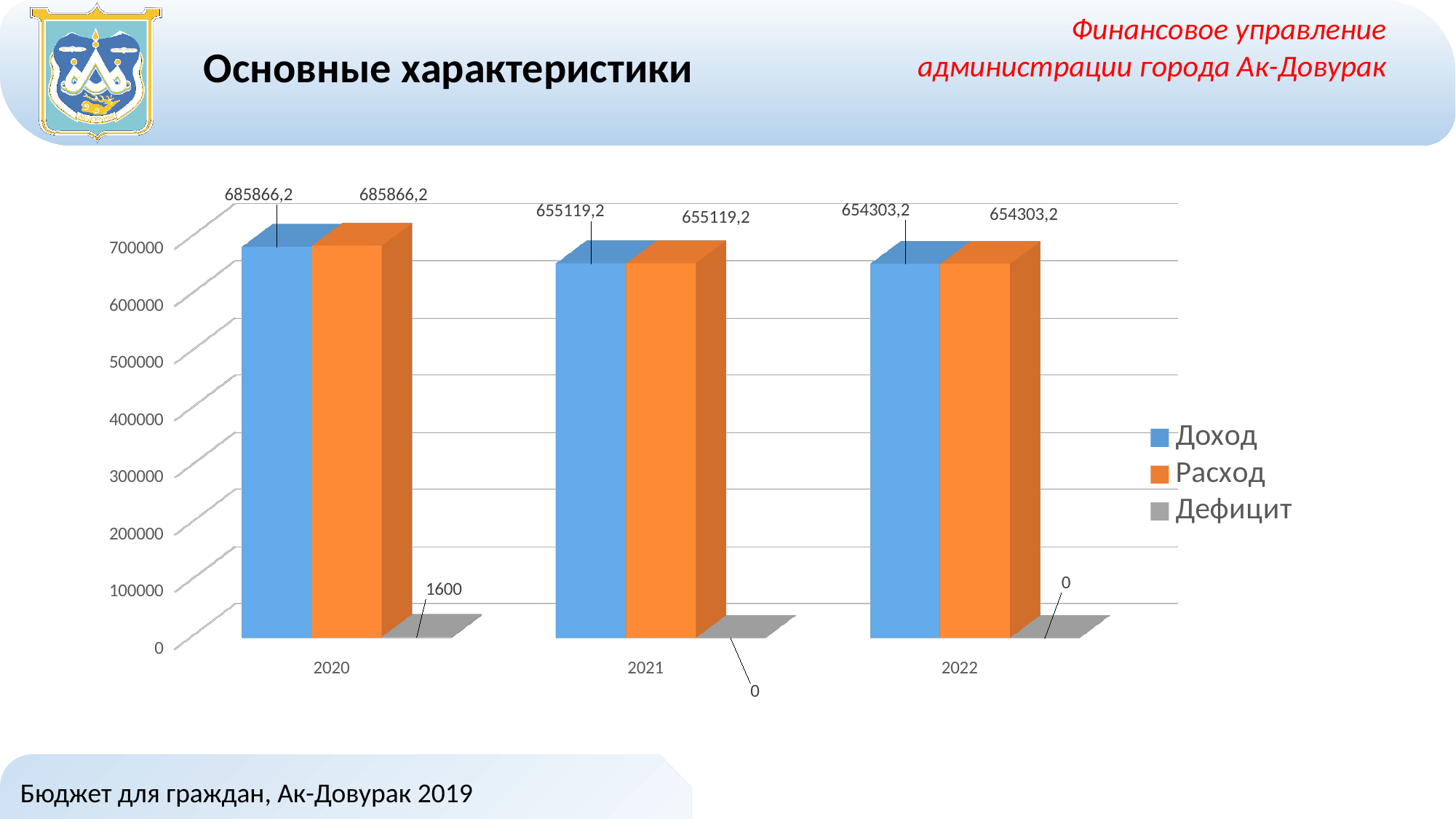
In which year is Дефицит the highest? 2020 Is the value of Доход for 2021 greater or less than 600000? greater What is the value of Доход for 2020? 685866,2 How many years are shown on the x axis? 3 In which year is Доход the highest? 2020 What is the difference between Доход in 2020 and Доход in 2021? 30747 What is the value of Доход for 2022? 654303,2 Does Доход rise or fall from 2020 to 2022? fall Which is larger: Расход in 2021 or Расход in 2022? Расход in 2021 What is the value of Дефицит for 2020? 1600 What is the value of Расход for 2021? 655119,2 How many series does the legend list? 3